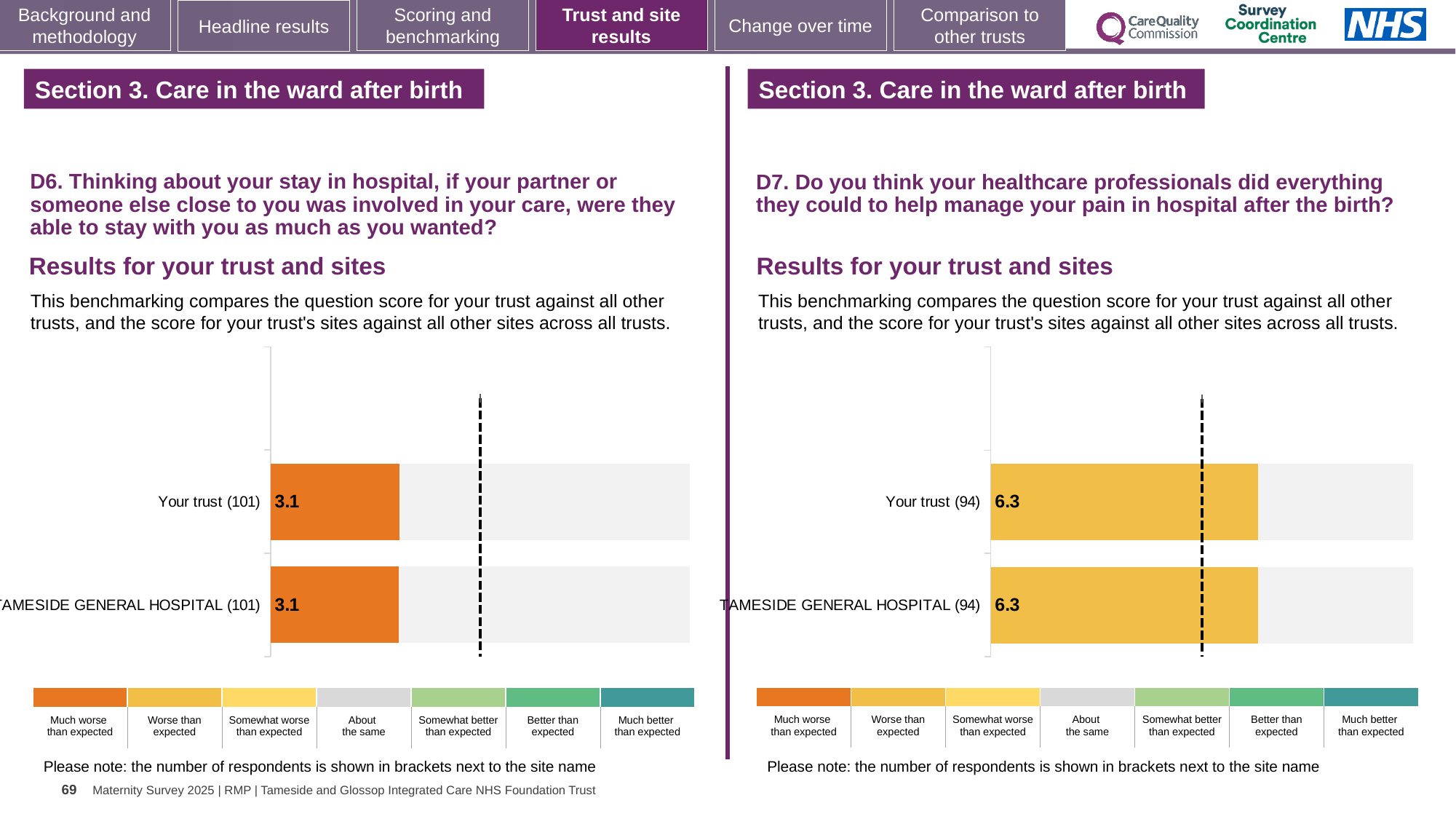
How many bars are plotted on the D7 chart (right)? 2 On the D7 chart (right), what is the difference between the score for Your trust and the score for TAMESIDE GENERAL HOSPITAL? 0.0 How many bars are plotted on the D6 chart (left)? 2 According to the legend, which benchmark category does the colour of the bars on the D7 chart (right) represent? Worse than expected What kind of chart is used for the D7 results (right)? Bar chart On the D6 chart (left), what is the difference between the score for Your trust and the score for TAMESIDE GENERAL HOSPITAL? 0.0 According to the legend, which benchmark category does the orange colour of the bars on the D6 chart (left) represent? Much worse than expected How many benchmark categories does the legend below the D6 chart (left) list? 7 On the D6 chart (left), what is the score for Your trust (101)? 3.1 On the D7 chart (right), what is the score for TAMESIDE GENERAL HOSPITAL (94)? 6.3 On the D6 chart (left), what is the score for TAMESIDE GENERAL HOSPITAL (101)? 3.1 On the D7 chart (right), what is the score for Your trust (94)? 6.3